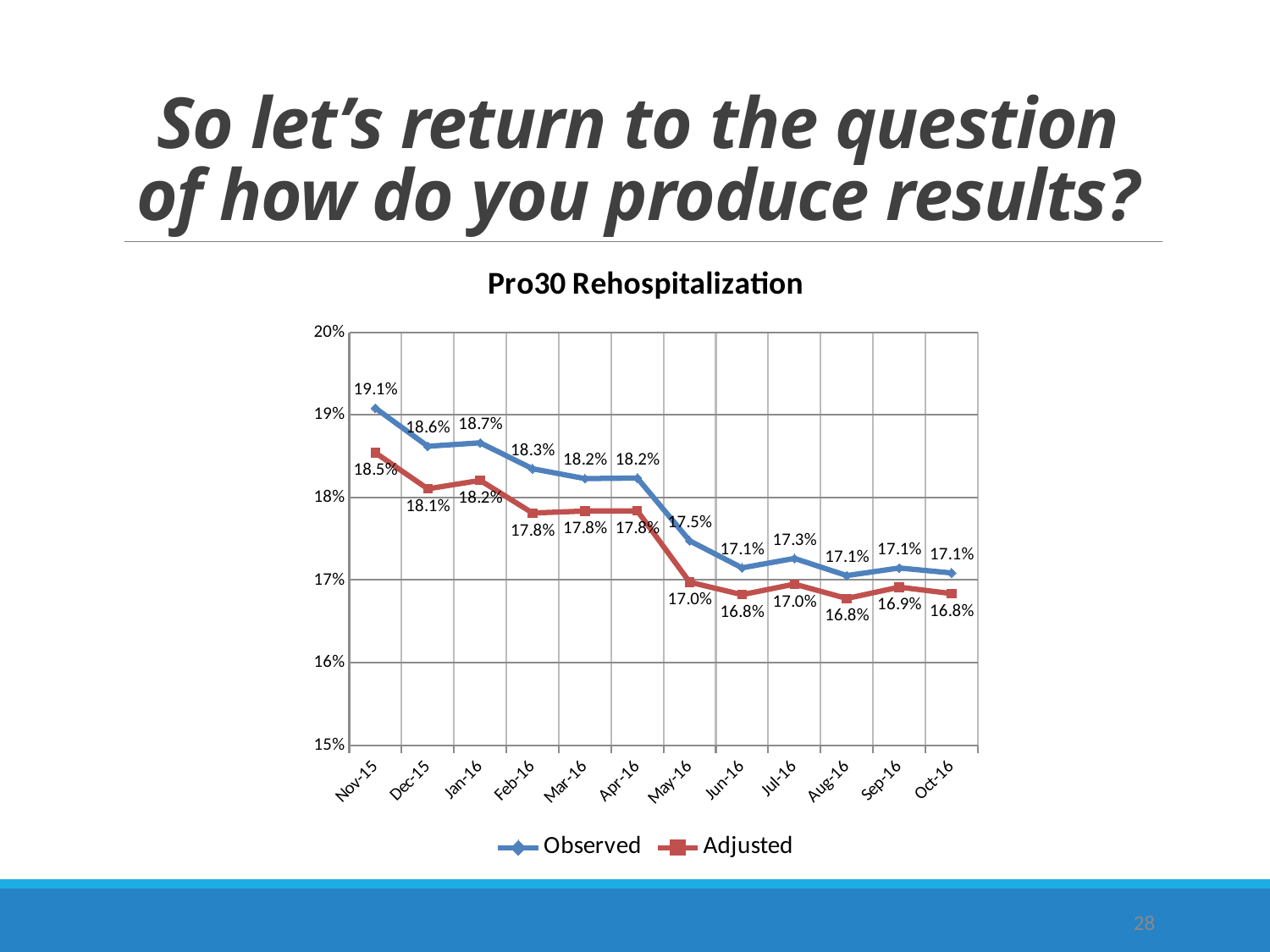
What type of chart is shown on the slide? line chart What is the difference between the Observed and Adjusted values for May-16? 0.5% What is the Adjusted value for Feb-16? 17.8% Do the Observed values generally rise or fall from Nov-15 to Oct-16? fall What is the title of the chart? Pro30 Rehospitalization Which is larger, the Observed value for Jan-16 or the Observed value for Dec-15? Jan-16 What is the Observed value for Jul-16? 17.3% In which month is the Observed value highest? Nov-15 What is the Adjusted value for Sep-16? 16.9% What is the Observed value for Nov-15? 19.1% How many months are plotted along the x axis? 12 How many series does the legend list? 2